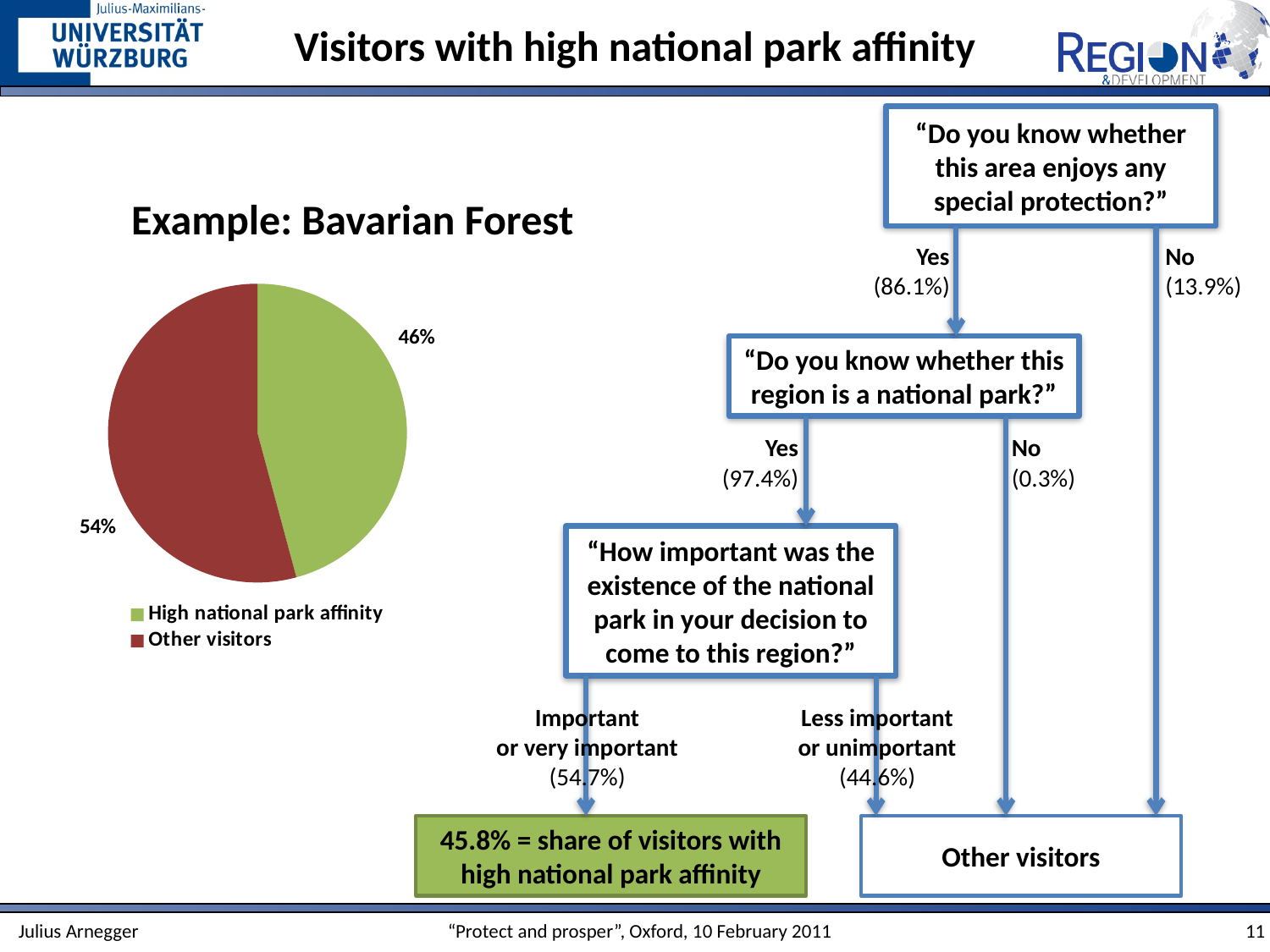
Which slice of the pie chart is the largest? Other visitors What share of the pie chart is labelled 'Other visitors'? 54% Which is larger in the pie chart: 'High national park affinity' or 'Other visitors'? Other visitors How many entries does the pie chart legend list? 2 What colour is the 'Other visitors' slice in the pie chart? red Is the 'High national park affinity' share in the pie chart greater or less than 50%? less How many slices does the pie chart have? 2 What is the difference in percentage points between the 'Other visitors' slice and the 'High national park affinity' slice? 8% What kind of chart is shown on the slide? pie chart What share of the pie chart is labelled 'High national park affinity'? 46% What colour is the 'High national park affinity' slice in the pie chart? green Which slice of the pie chart is the smallest? High national park affinity